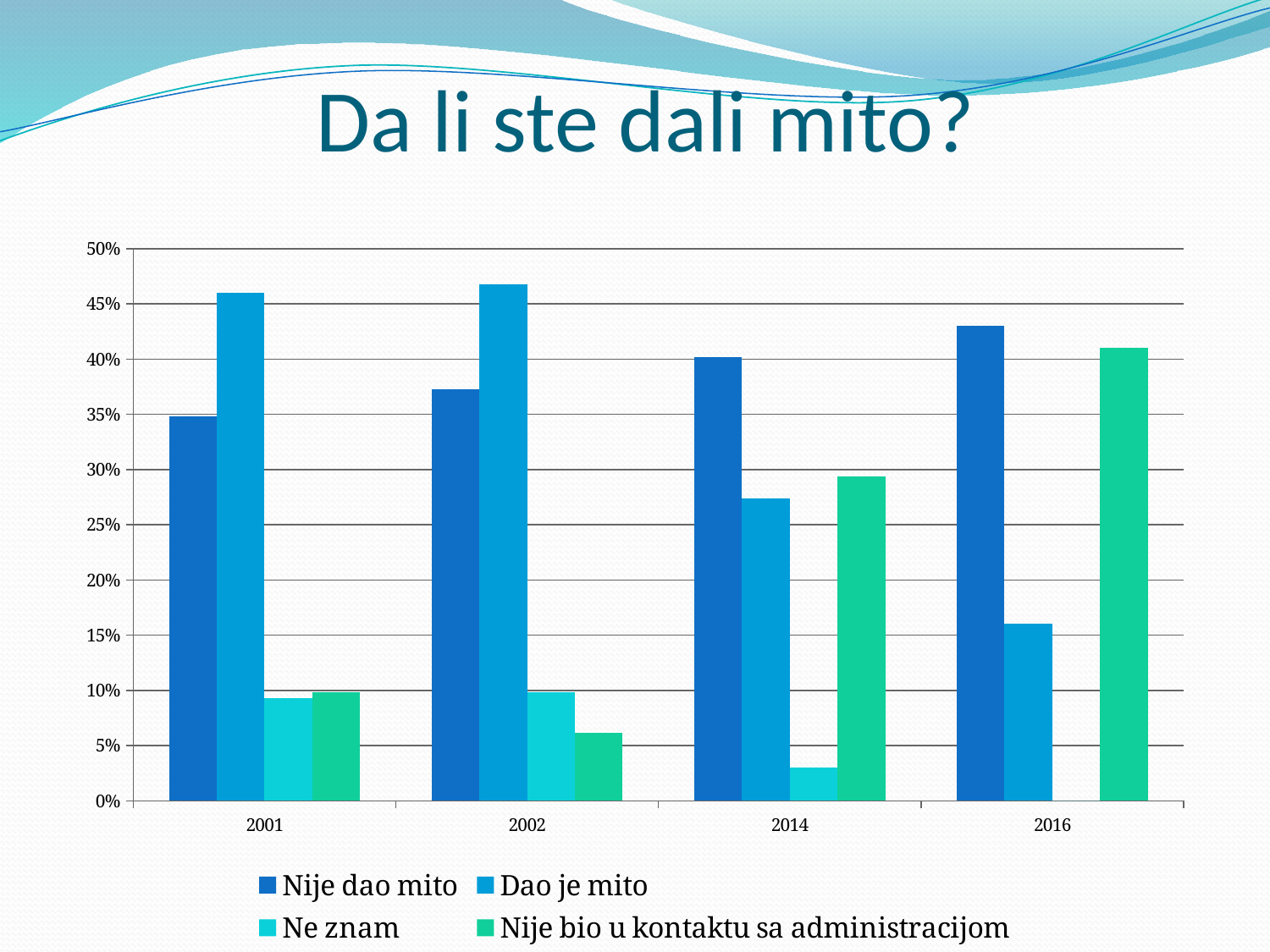
In which year is the value for Ne znam lowest? 2016 How many series does the legend list? 4 What is the title of the chart? Da li ste dali mito? In which year is the value for Nije bio u kontaktu sa administracijom highest? 2016 Does the value for Nije dao mito rise or fall from 2001 to 2016? rise In 2014, which is larger: Nije dao mito or Dao je mito? Nije dao mito In which year is the value for Nije dao mito highest? 2016 In 2001, which is larger: Nije dao mito or Dao je mito? Dao je mito What kind of chart is shown on the slide? bar chart Is the value for Ne znam in 2014 greater or less than 5%? less How many years are shown on the x axis? 4 In which year is the value for Dao je mito lowest? 2016